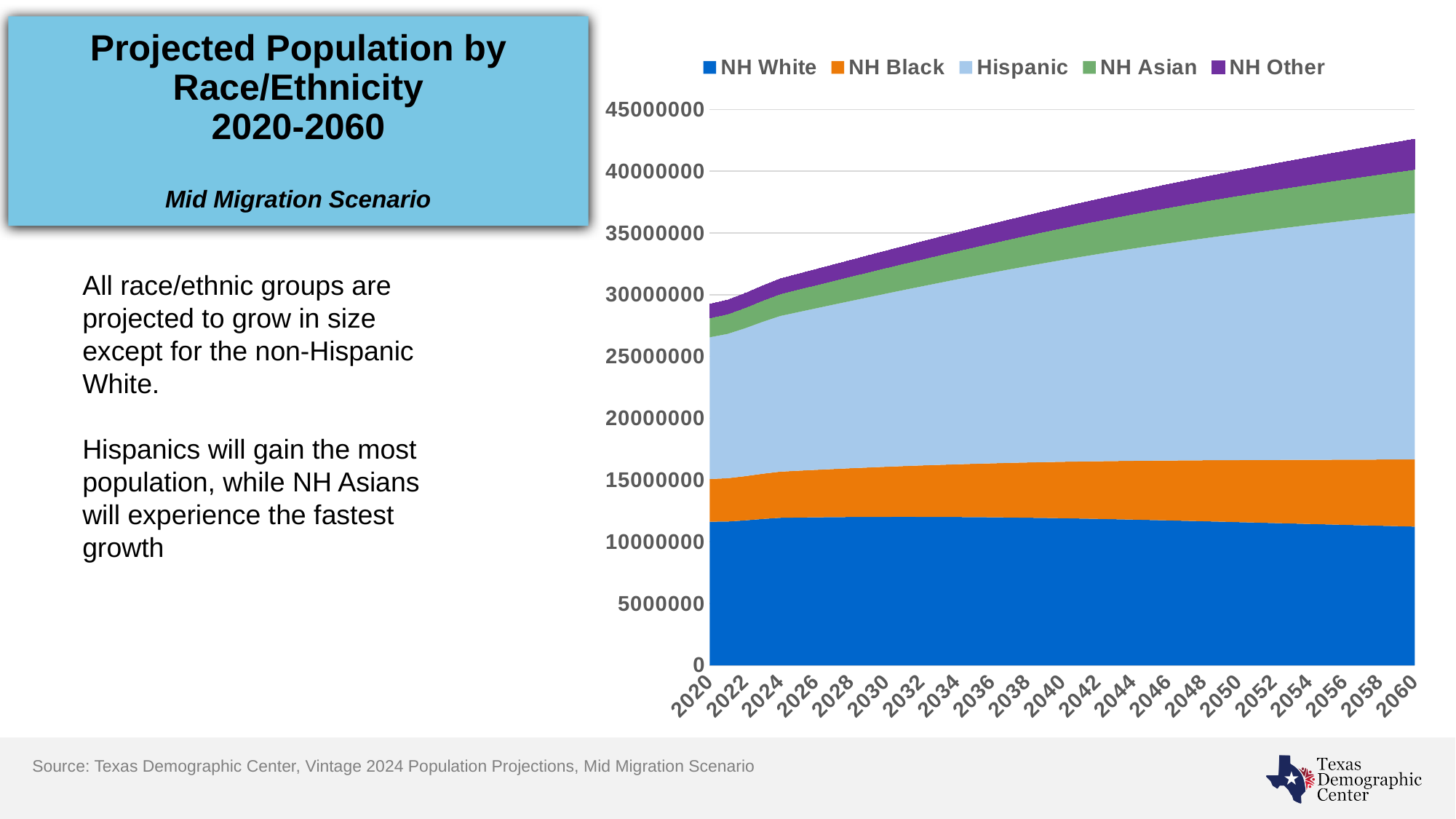
Which series is shown in orange? NH Black Is the total projected population in 2060 greater or less than 40000000? greater Is the total projected population in 2030 greater or less than 30000000? greater How many series does the legend list? 5 Is the total projected population in 2040 greater or less than 35000000? greater What kind of chart is shown on the slide? Stacked area chart Which race/ethnicity group occupies the largest band in the chart? Hispanic Does the NH White band rise or fall across the years shown? Fall What is the first series listed in the legend? NH White How many year labels are shown along the x axis? 21 Does the total projected population rise or fall from 2020 to 2060? Rise